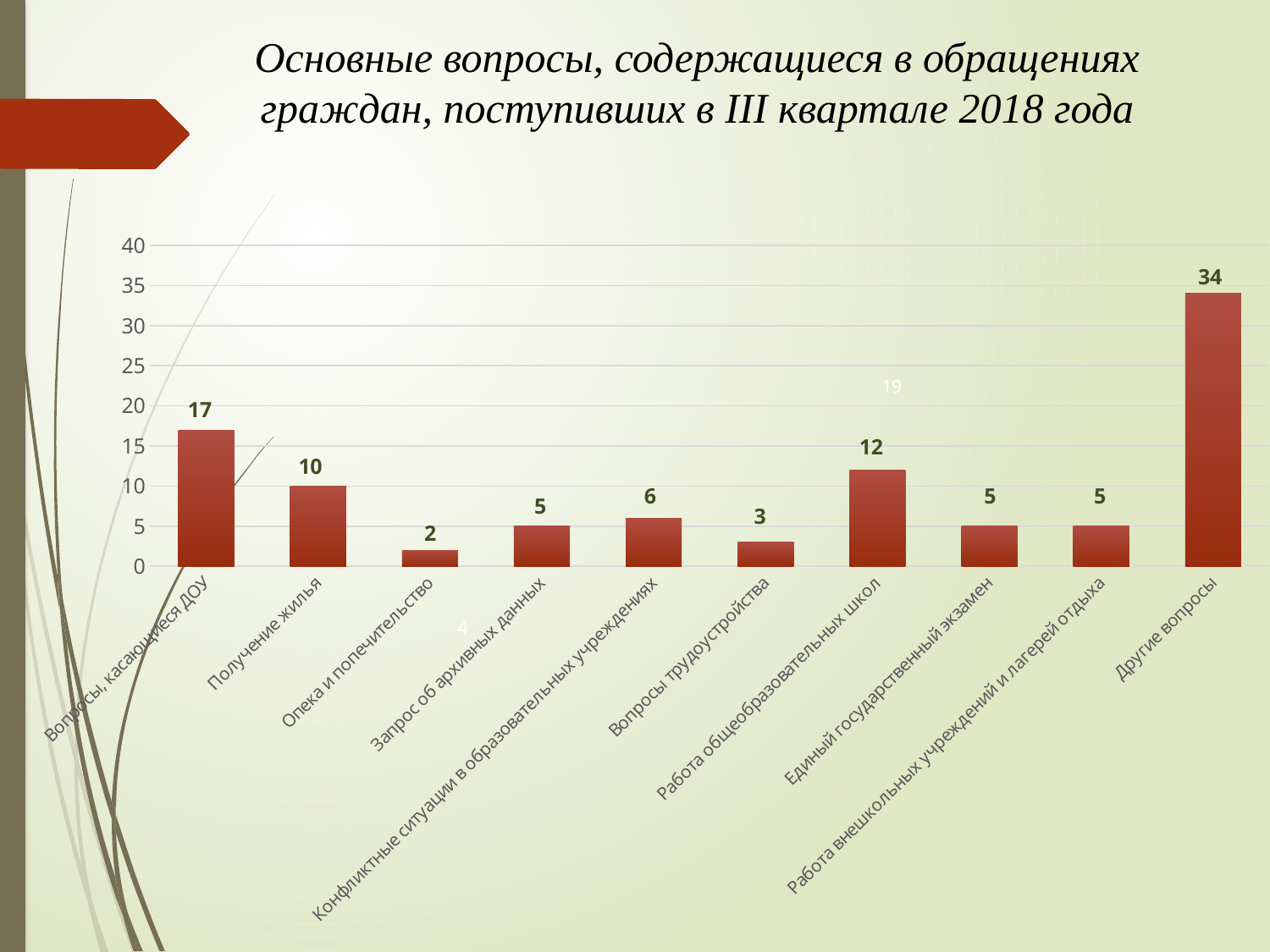
Which category has the lowest value? Опека и попечительство What is the value for «Работа общеобразовательных школ»? 12 What is the difference between «Вопросы, касающиеся ДОУ» and «Получение жилья»? 7 Which is larger: «Вопросы трудоустройства» or «Конфликтные ситуации в образовательных учреждениях»? Конфликтные ситуации в образовательных учреждениях What is the value for «Опека и попечительство»? 2 What is the value for «Получение жилья»? 10 Which category has the highest value? Другие вопросы What kind of chart is shown on the slide? bar chart Is the value for «Другие вопросы» greater or less than 30? greater What is the title of the slide? Основные вопросы, содержащиеся в обращениях граждан, поступивших в III квартале 2018 года How many categories are shown on the chart? 10 What is the difference between «Другие вопросы» and «Вопросы, касающиеся ДОУ»? 17